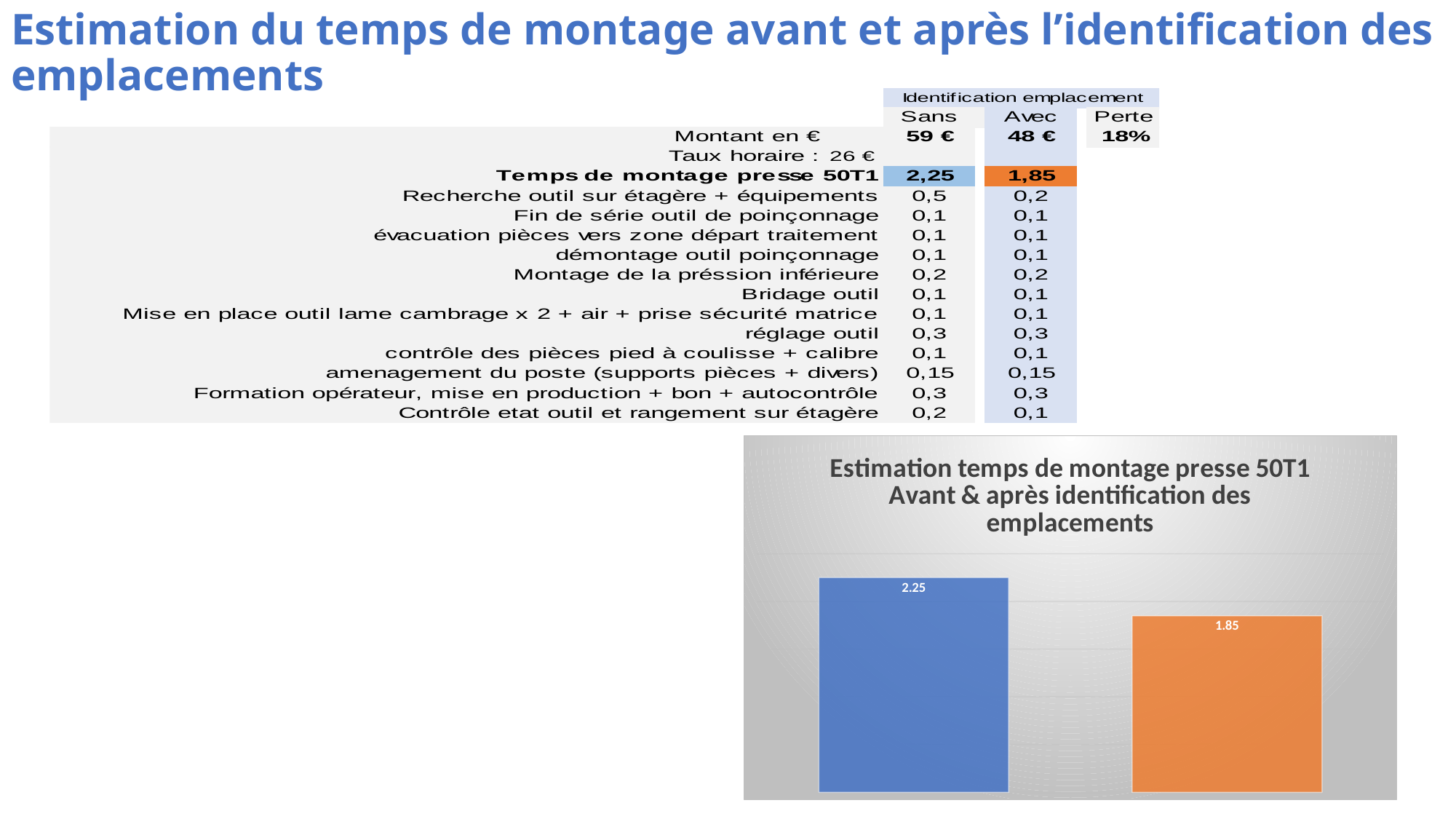
Which bar in the chart has the lowest value? the orange (right) bar What is the title of the chart? Estimation temps de montage presse 50T1 Avant & après identification des emplacements What value is labelled on the blue (left) bar of the chart? 2.25 What is the difference between the values of the blue bar and the orange bar in the chart? 0.4 Do the bar values rise or fall from left to right in the chart? fall What value is labelled on the orange (right) bar of the chart? 1.85 How many bars are plotted in the chart? 2 What colour is the bar with the value 1.85? orange Is the value of the blue bar larger or smaller than the value of the orange bar? larger What type of chart is shown on the slide? bar chart Which bar in the chart is the tallest, the blue one or the orange one? the blue one